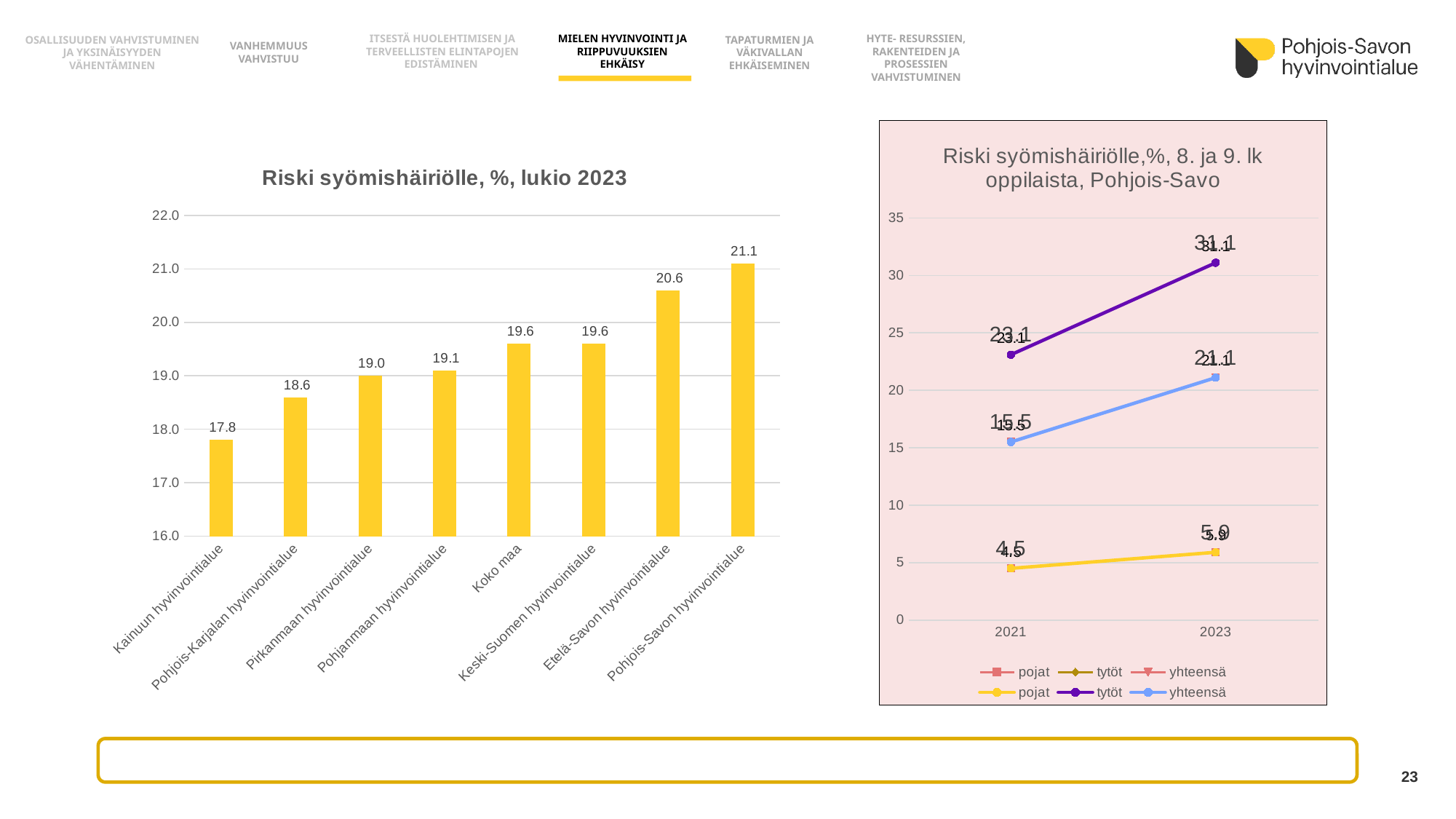
In the chart titled 'Riski syömishäiriölle, %, lukio 2023', do the values rise or fall from left to right along the x axis? rise In the chart titled 'Riski syömishäiriölle, %, lukio 2023', what is the value for Kainuun hyvinvointialue? 17.8 What kind of chart is the one on the right titled 'Riski syömishäiriölle,%, 8. ja 9. lk oppilaista, Pohjois-Savo'? line chart What kind of chart is the one titled 'Riski syömishäiriölle, %, lukio 2023'? bar chart In the chart titled 'Riski syömishäiriölle, %, lukio 2023', which category has the highest value? Pohjois-Savon hyvinvointialue In the chart on the right titled 'Riski syömishäiriölle,%, 8. ja 9. lk oppilaista, Pohjois-Savo', what is the value for pojat in 2021? 4.5 In the chart on the right titled 'Riski syömishäiriölle,%, 8. ja 9. lk oppilaista, Pohjois-Savo', what is the value for tytöt in 2023? 31.1 In the chart titled 'Riski syömishäiriölle, %, lukio 2023', what is the difference between Pohjois-Savon hyvinvointialue and Kainuun hyvinvointialue? 3.3 In the chart on the right titled 'Riski syömishäiriölle,%, 8. ja 9. lk oppilaista, Pohjois-Savo', what is the difference between the yhteensä values for 2023 and 2021? 5.6 In the chart titled 'Riski syömishäiriölle, %, lukio 2023', which category has the lowest value? Kainuun hyvinvointialue In the chart titled 'Riski syömishäiriölle, %, lukio 2023', what is the value for Koko maa? 19.6 In the chart titled 'Riski syömishäiriölle, %, lukio 2023', how many categories are shown on the x axis? 8